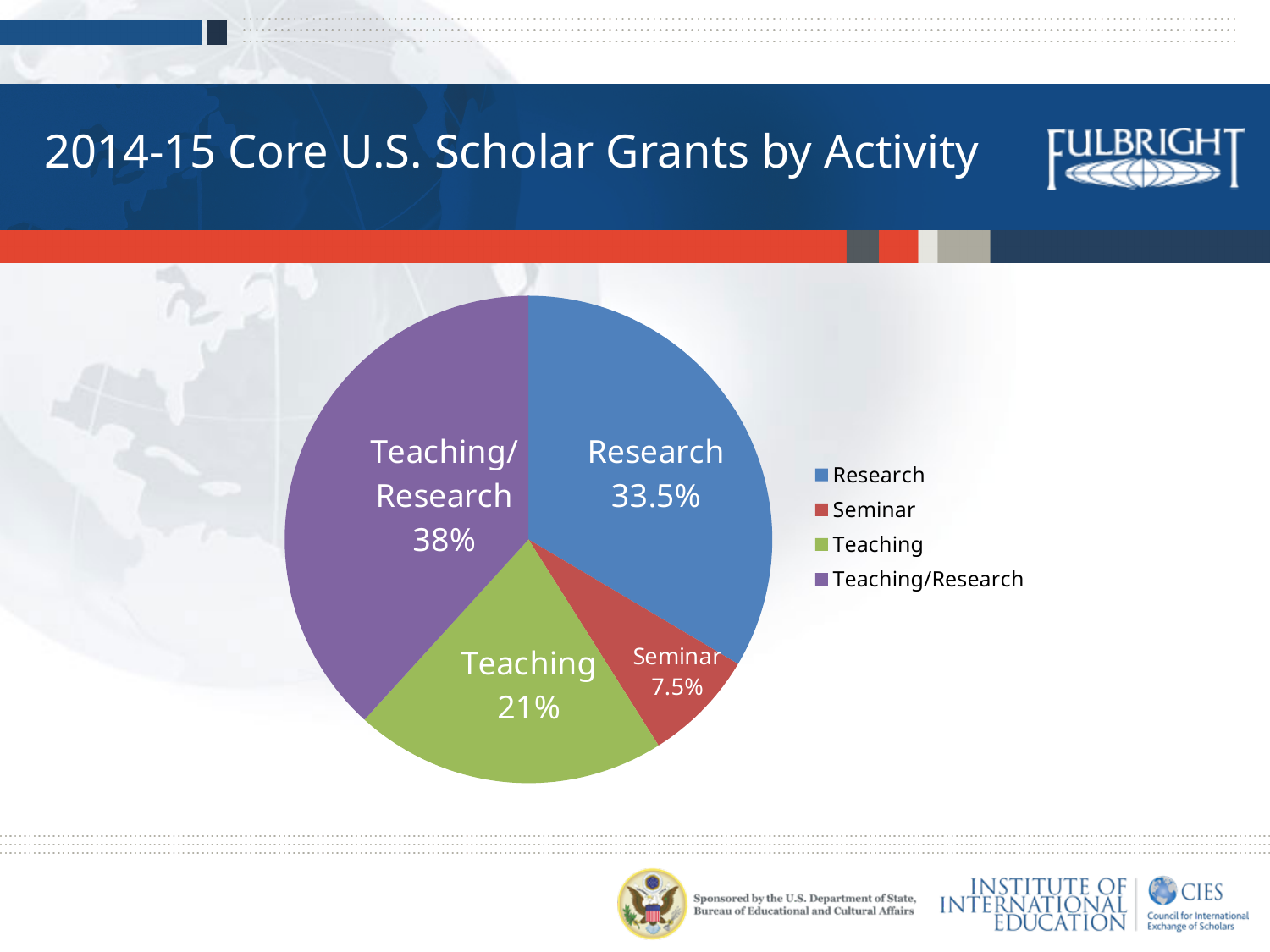
Which is larger, the share for Research or the share for Teaching? Research Which activity has the largest share of grants? Teaching/Research What share of grants is for Teaching? 21% What share of grants is for Research? 33.5% What is the difference in percentage points between the Teaching/Research share and the Research share? 4.5 What share of grants is for Teaching/Research? 38% What kind of chart is shown on the slide? pie chart What share of grants is for Seminar? 7.5% What is the difference in percentage points between the Teaching share and the Seminar share? 13.5 Which activity has the smallest share of grants? Seminar How many activity categories does the pie chart show? 4 What is the title of the chart on the slide? 2014-15 Core U.S. Scholar Grants by Activity